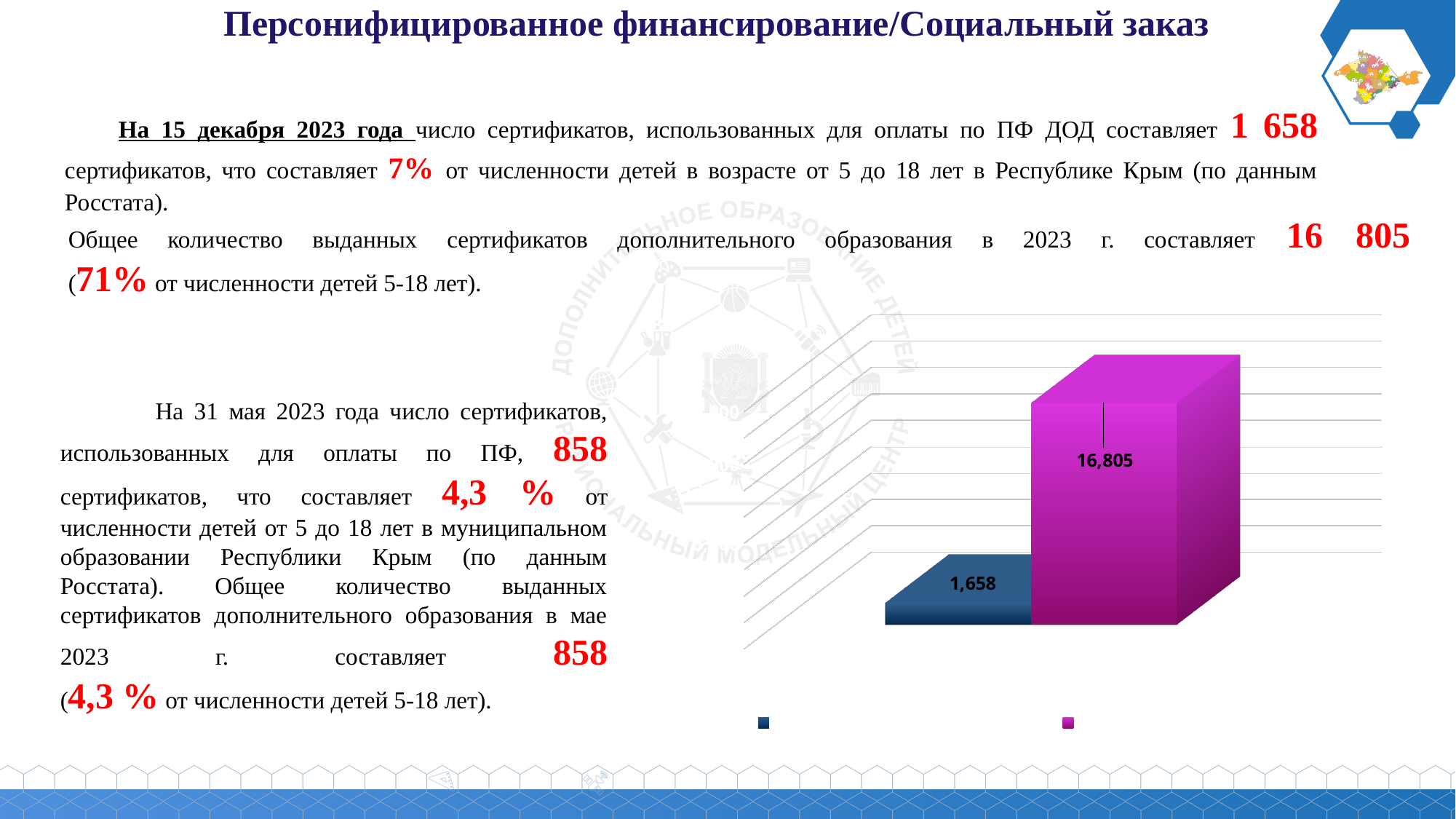
How many legend markers are shown below the chart? 2 Which bar in the chart has the highest value, the dark blue one or the magenta one? the magenta bar What is the difference between the values of the magenta bar and the dark blue bar in the chart? 15,147 How many bars are plotted in the chart? 2 What value is printed on the magenta bar in the chart? 16,805 What kind of chart is shown on the slide? bar chart What colour is the bar labelled 16,805? magenta Which bar in the chart has the lowest value, the dark blue one or the magenta one? the dark blue bar Is the value of the dark blue bar larger or smaller than the value of the magenta bar? smaller What colour is the bar labelled 1,658? dark blue What value is printed on the dark blue bar in the chart? 1,658